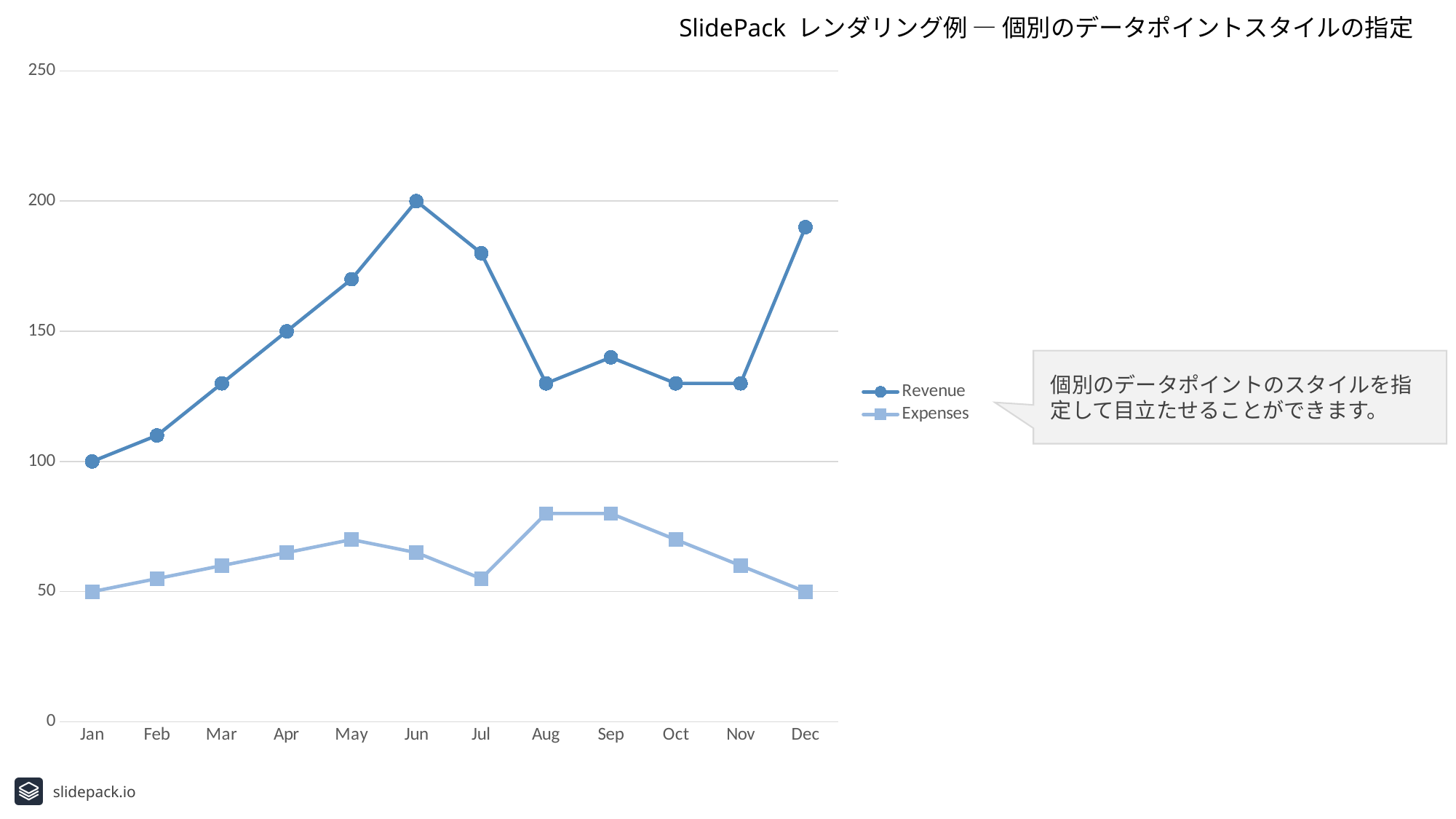
In which month is Revenue lowest? Jan What is the Expenses value for Jan? 50 What is the difference between Revenue in Jun and Revenue in Jan? 100 Is the Revenue value for Dec greater or less than 150? greater How many months are plotted along the x axis? 12 Which is larger, Revenue in Jun or Revenue in Dec? Jun What is the Revenue value for Jun? 200 What type of chart is shown on the slide? line chart In which month is Revenue highest? Jun What is the Revenue value for Jan? 100 How many series does the legend list? 2 Does Revenue rise or fall from Jan to Jun? rise